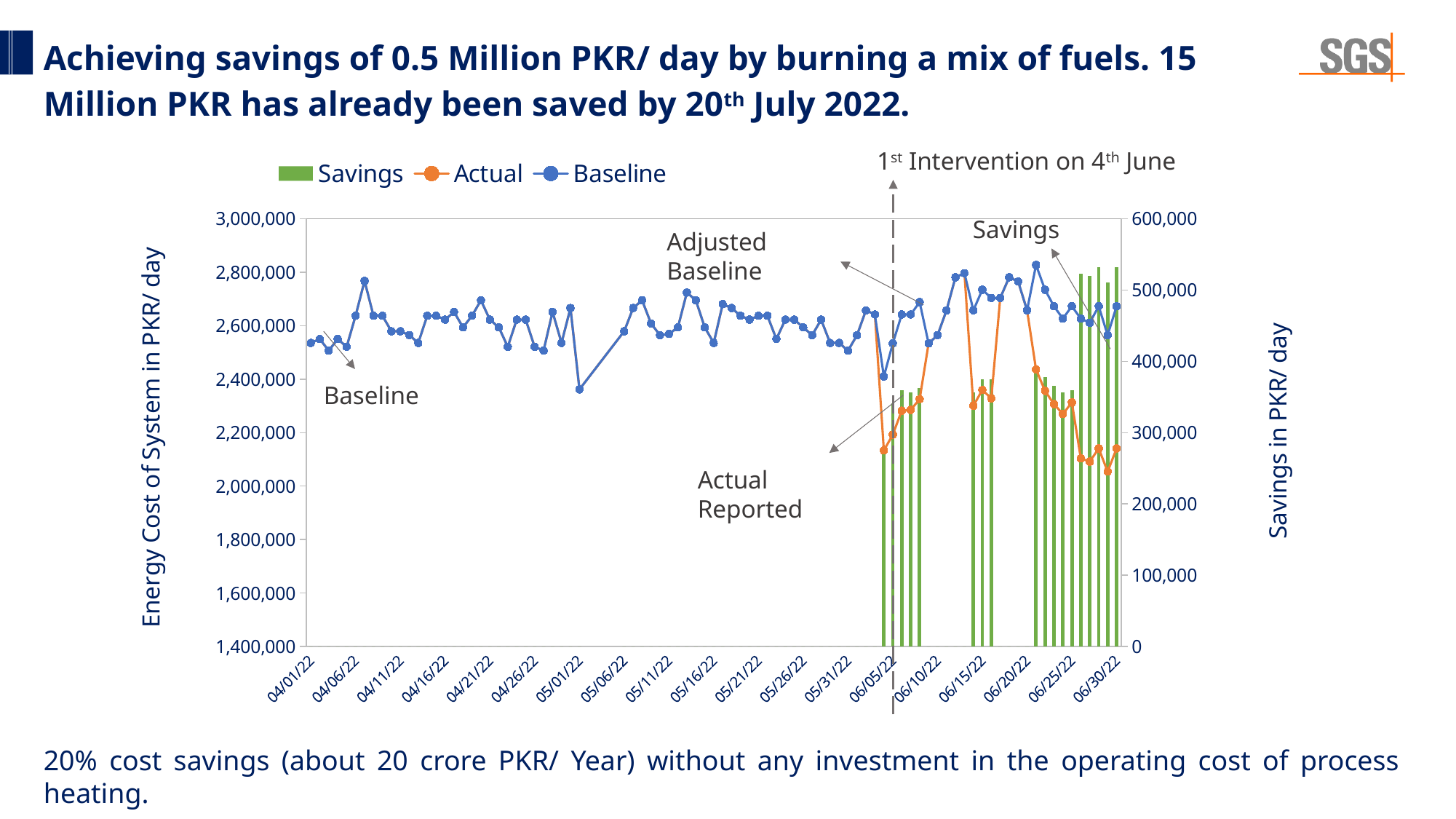
Is the Actual value on 06/30/22 greater or less than 2,400,000? less What is the title of the left vertical axis? Energy Cost of System in PKR/ day On 06/30/22, which is larger: the Baseline value or the Actual value? Baseline Is the Actual value on 06/05/22 greater or less than 2,400,000? less How many date labels are shown on the x axis? 19 Does the Actual line rise or fall overall between 06/20/22 and 06/30/22? fall Which series is plotted as bars? Savings What kind of chart is shown on the slide? A combination line and bar chart How many series does the legend list? 3 What is the highest tick value shown on the right vertical axis? 600,000 Is the Savings bar on 06/30/22 greater or less than 400,000 on the right axis? greater